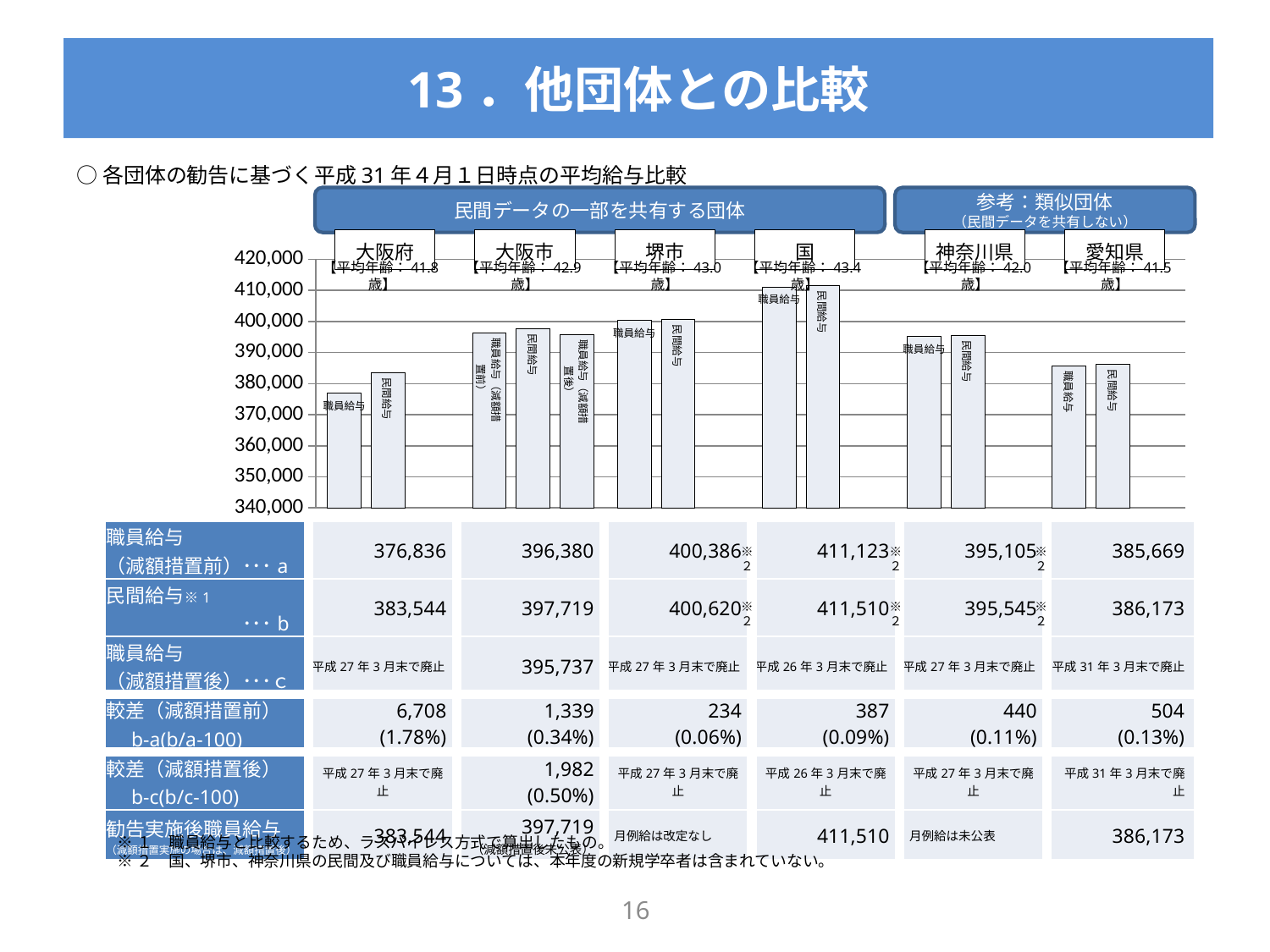
What kind of chart is shown on the slide? bar chart What is the 民間給与 value for 愛知県? 386,173 What is the 民間給与 value for 国? 411,510 Which is larger, the 職員給与 for 神奈川県 or the 職員給与 for 愛知県? 神奈川県 What is the 職員給与（減額措置前） value for 大阪府? 376,836 What is the difference between 民間給与 and 職員給与（減額措置前） for 大阪府? 6,708 Is the 民間給与 bar for 堺市 greater or less than 390,000? greater Which organization has the highest 民間給与 bar? 国 What is the 職員給与（減額措置後） value for 大阪市? 395,737 Which organizations are grouped under the heading 参考：類似団体（民間データを共有しない）? 神奈川県 and 愛知県 How many organizations (団体) are compared along the x axis of the chart? 6 Which organization has the lowest 職員給与 bar? 大阪府